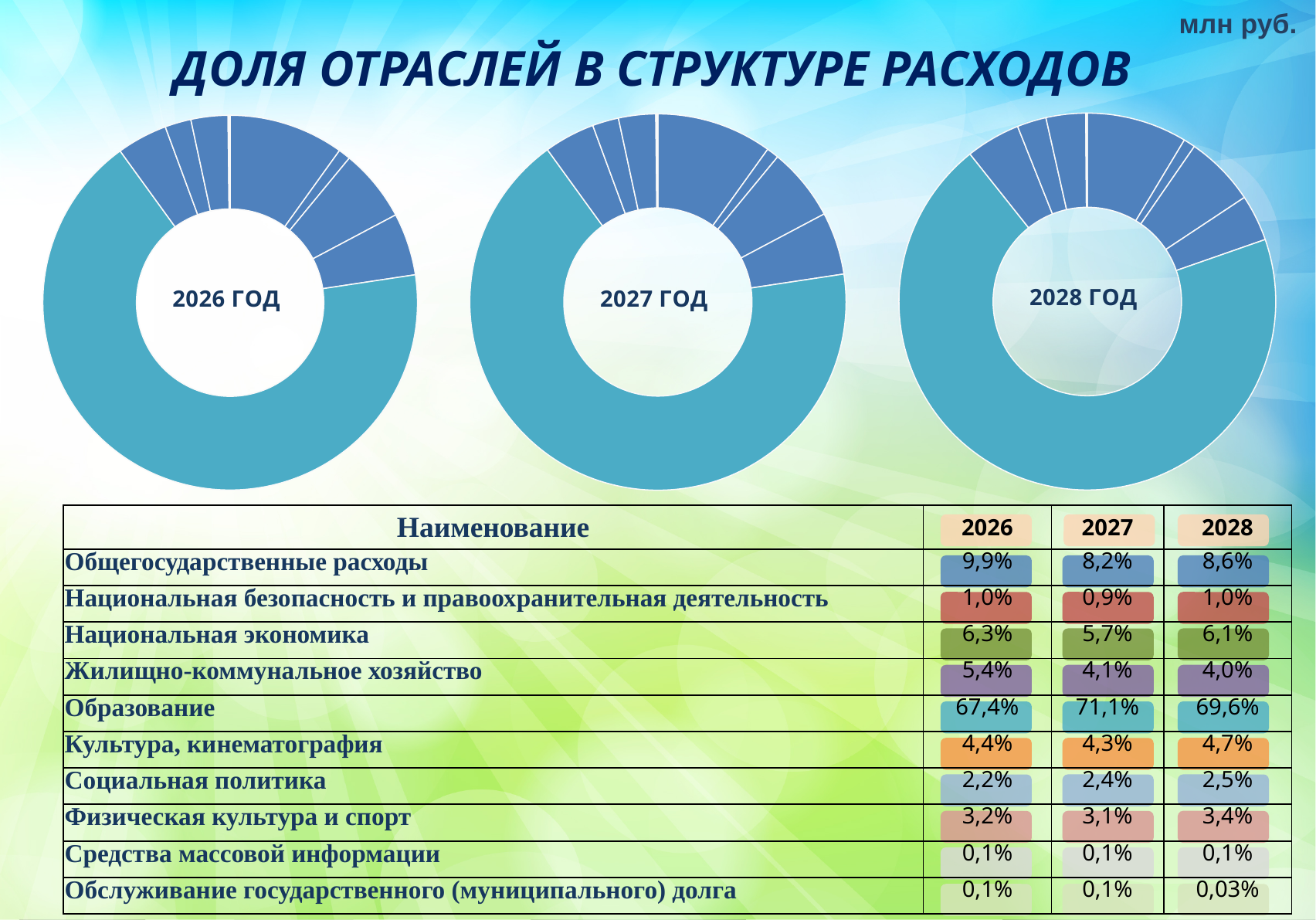
According to the table, what is the share of Общегосударственные расходы in 2026? 9,9% According to the table, what is the share of Образование in 2027? 71,1% How many expenditure categories are listed in the table under Наименование? 10 Which category has the smallest share in 2028? Обслуживание государственного (муниципального) долга What kind of chart is used to show the 2026 ГОД expenditure structure? Donut (pie) chart By how many percentage points does the share of Образование in 2027 exceed its share in 2026? 3,7 Which category has the largest share in the 2026 ГОД chart? Образование How many donut charts are shown on the slide? 3 According to the table, what is the share of Обслуживание государственного (муниципального) долга in 2028? 0,03% Is the share of Образование larger in 2026 or in 2027? 2027 According to the table, what is the share of Культура, кинематография in 2028? 4,7% What unit is indicated in the top right corner of the slide? млн руб.